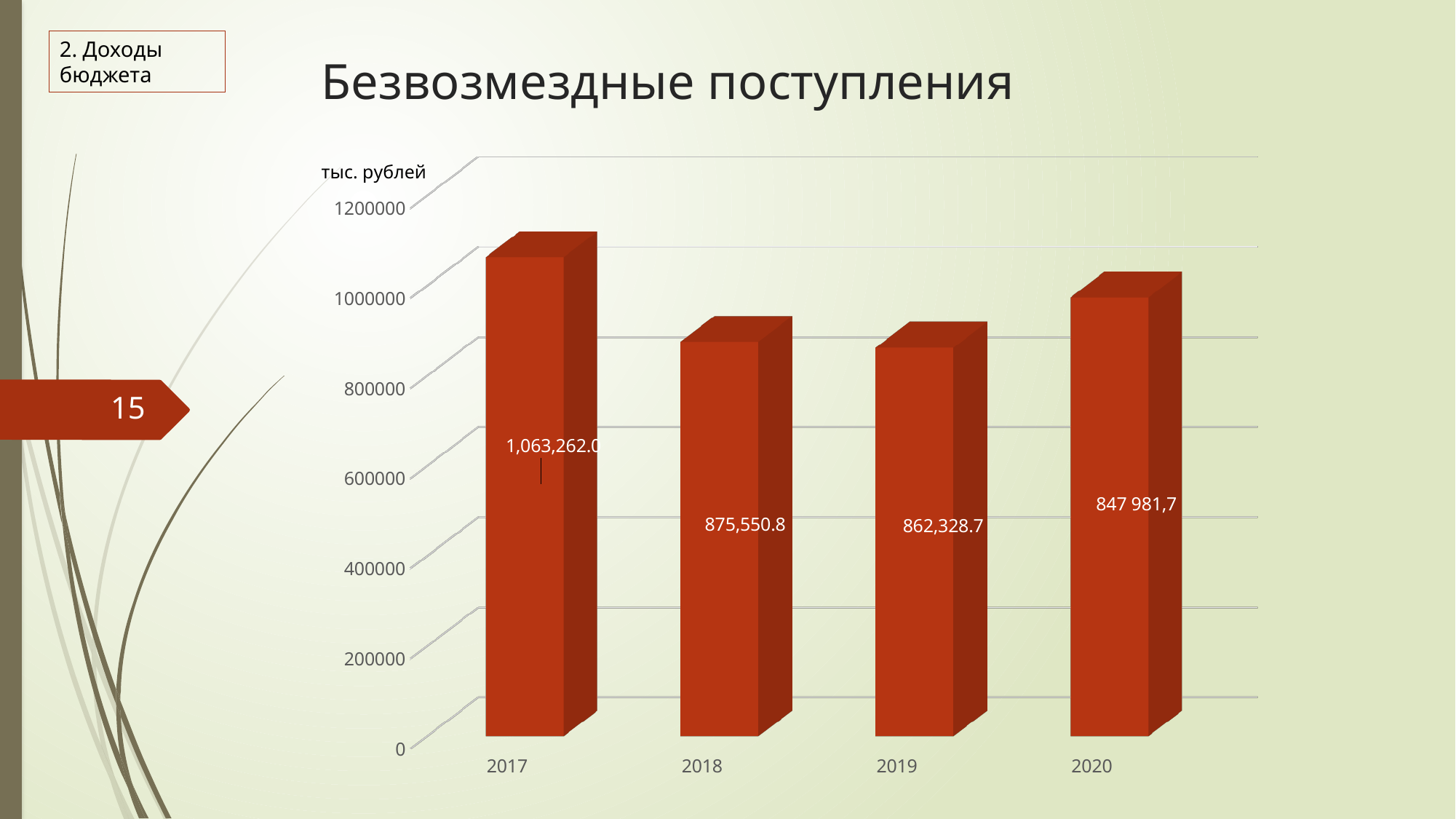
Which is larger, the value for 2017 or the value for 2018? 2017 Which year has the highest value? 2017 Is the value for 2018 greater or less than 1000000? less Is the value for 2019 greater or less than 800000? greater How many years are shown on the x axis? 4 What is the title of the chart? Безвозмездные поступления What is the value for 2018? 875,550.8 What kind of chart is shown on the slide? bar chart What is the value for 2017? 1,063,262.0 What is the value for 2019? 862,328.7 What is the difference between the values for 2017 and 2018? 187,711.2 What is the value for 2020? 847 981,7